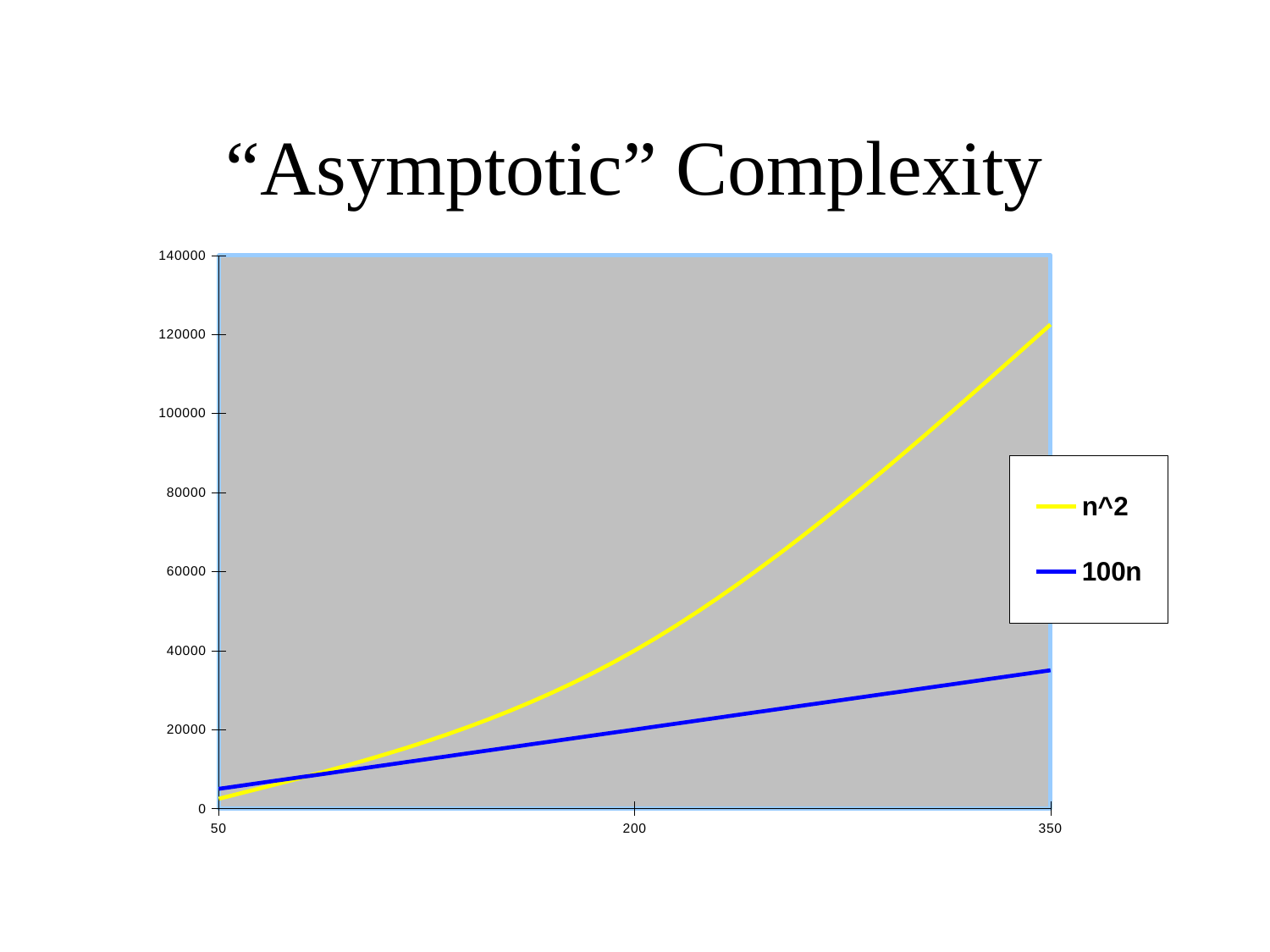
What is the title of the slide containing the chart? "Asymptotic" Complexity Which series reaches the highest value on the chart? n^2 Which series is drawn in yellow? n^2 At x = 350, which series has the larger value, n^2 or 100n? n^2 Is the value of 100n at x = 350 greater or less than 40000? less Is the value of n^2 at x = 350 greater or less than 100000? greater Is the value of 100n at x = 200 greater or less than 40000? less Does the 100n series rise or fall as x increases from 50 to 350? rise Does the n^2 series rise or fall as x increases from 50 to 350? rise How many series does the legend list? 2 What kind of chart is shown on the slide? line chart